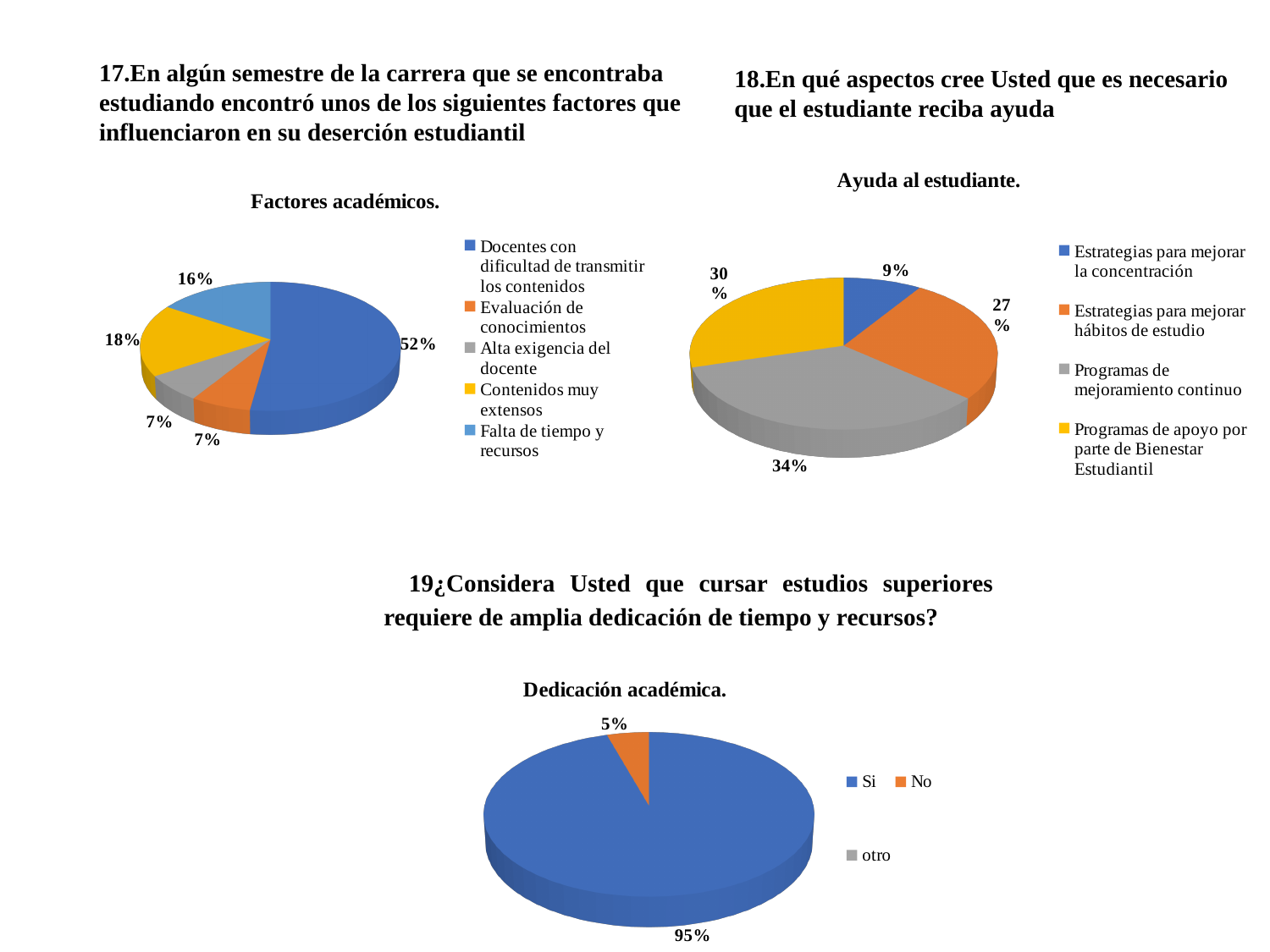
In the 'Dedicación académica.' chart, what share is shown for 'Si'? 95% In the 'Factores académicos.' chart, what is the difference between 'Contenidos muy extensos' and 'Falta de tiempo y recursos'? 2% In the 'Factores académicos.' chart, which category has the largest slice? Docentes con dificultad de transmitir los contenidos In the 'Ayuda al estudiante.' chart, which category has the smallest slice? Estrategias para mejorar la concentración In the 'Factores académicos.' chart, what share is shown for 'Docentes con dificultad de transmitir los contenidos'? 52% How many legend entries does the 'Factores académicos.' chart list? 5 In the 'Ayuda al estudiante.' chart, which is larger: 'Estrategias para mejorar hábitos de estudio' or 'Programas de apoyo por parte de Bienestar Estudiantil'? Programas de apoyo por parte de Bienestar Estudiantil What kind of chart is 'Dedicación académica.'? Pie chart In the 'Factores académicos.' chart, what share is shown for 'Contenidos muy extensos'? 18% In the 'Dedicación académica.' chart, what colour is the 'No' slice? Orange In the 'Ayuda al estudiante.' chart, what is the difference between 'Programas de mejoramiento continuo' and 'Estrategias para mejorar la concentración'? 25% In the 'Ayuda al estudiante.' chart, what share is shown for 'Programas de mejoramiento continuo'? 34%